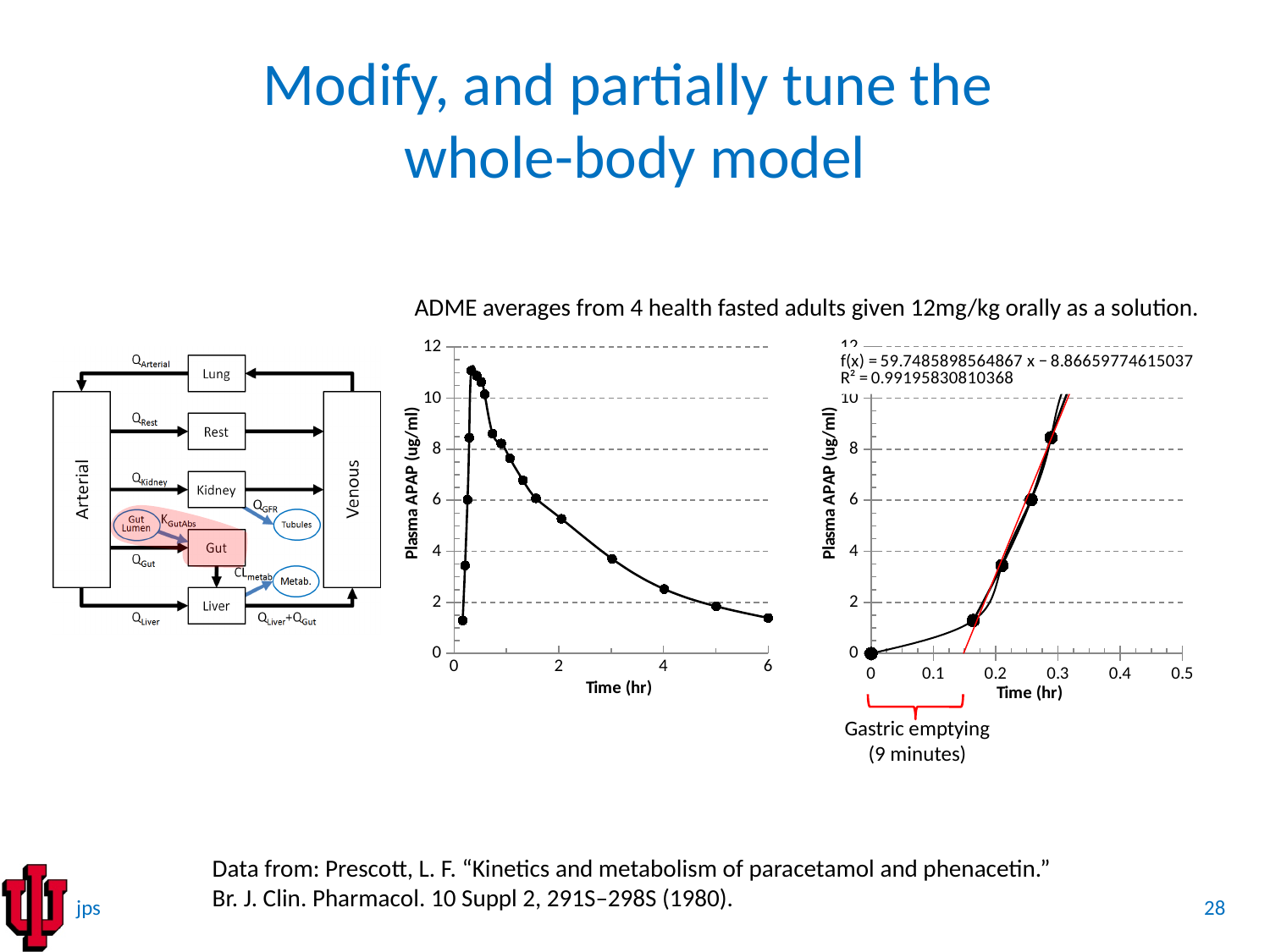
On the left chart, is the peak plasma APAP value greater or less than 10? greater On the left chart, what is the y-axis title? Plasma APAP (ug/ml) On the left chart, do the plasma APAP values rise or fall between 1 hr and 6 hr? fall On the left chart, is the plasma APAP value at 6 hr greater or less than 2? less On the right chart (Time 0 to 0.5 hr), do the plasma APAP values rise or fall as time increases? rise On the left chart, what is the x-axis title? Time (hr) On the right chart, is the plasma APAP value at 0.3 hr greater or less than 8? greater What kind of chart is the left chart (Time 0 to 6 hr)? line chart On the right chart, what R² value is printed for the fitted line? R² = 0.99195830810368 On the left chart, which is larger: the plasma APAP value at 2 hr or at 4 hr? 2 hr